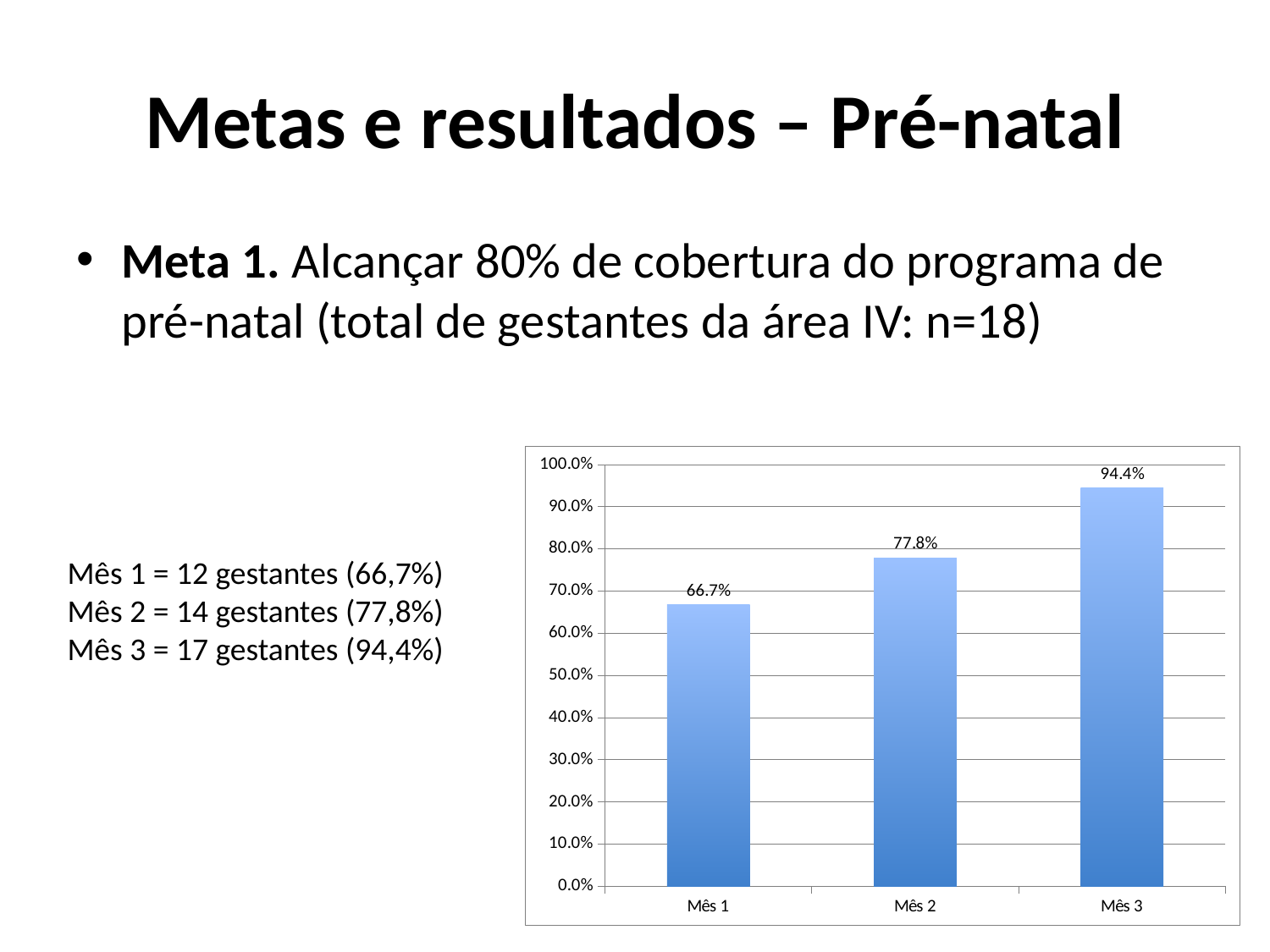
Which is larger, the value for Mês 2 or the value for Mês 3? Mês 3 Is the value for Mês 2 greater or less than 80%? less What kind of chart is shown on the slide? bar chart What is the value for Mês 2? 77.8% Which month has the lowest value? Mês 1 What is the value for Mês 3? 94.4% How many categories are shown on the x axis? 3 What is the difference between the values for Mês 2 and Mês 1? 11.1% Do the values rise or fall from Mês 1 to Mês 3? rise What is the difference between the values for Mês 3 and Mês 1? 27.7% What is the value for Mês 1? 66.7% Which month has the highest value? Mês 3